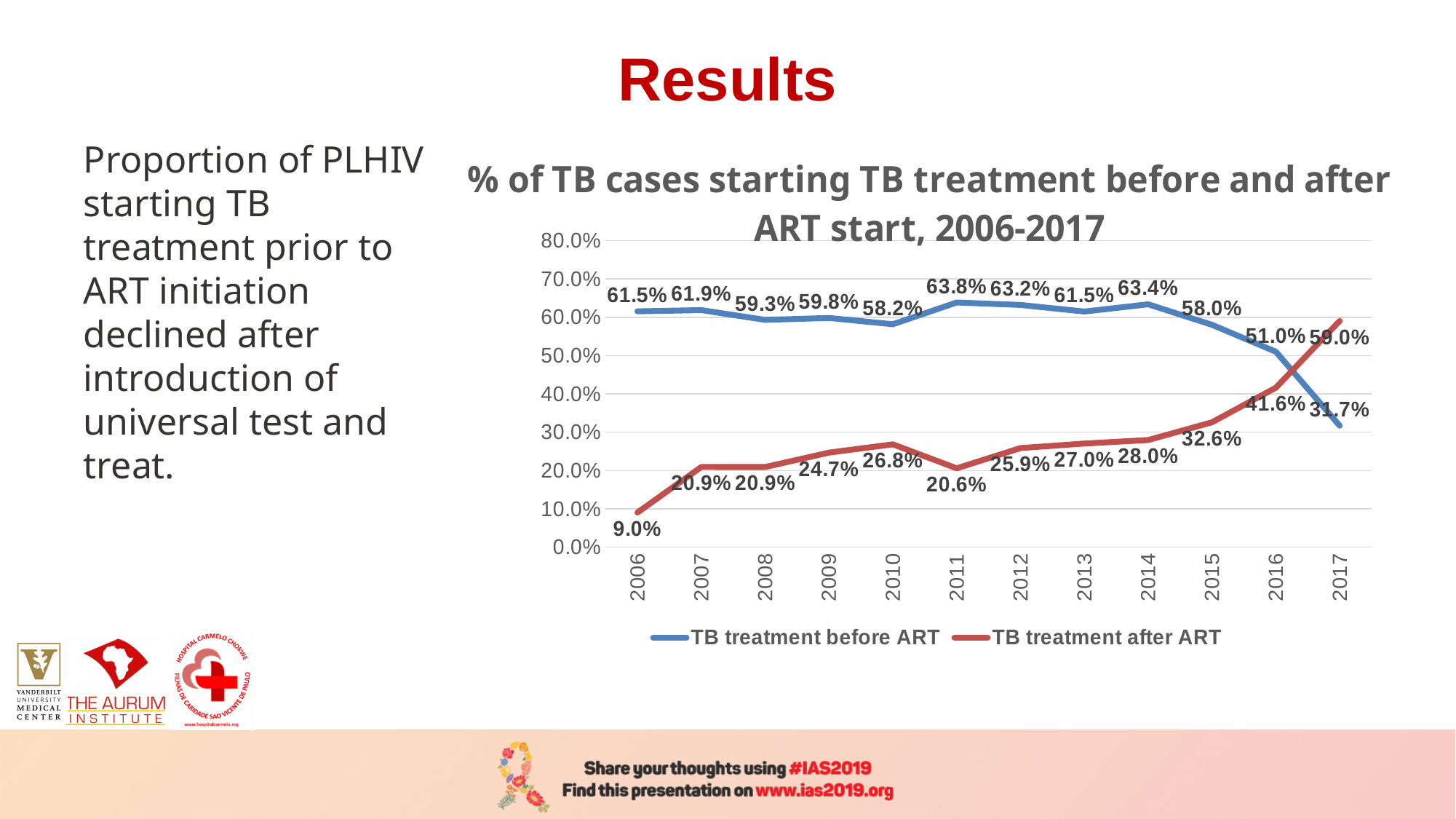
How many years are shown on the x axis? 12 In 2016, which is larger: TB treatment before ART or TB treatment after ART? TB treatment before ART What is the difference between TB treatment after ART and TB treatment before ART in 2017? 27.3 percentage points Does TB treatment after ART rise or fall from 2011 to 2017? Rise In which year is TB treatment after ART at its highest? 2017 What kind of chart is shown on the slide? Line chart How many series does the legend list? 2 What is the value for TB treatment after ART in 2015? 32.6% What is the value for TB treatment after ART in 2006? 9.0% In which year is TB treatment after ART at its lowest? 2006 What is the value for TB treatment before ART in 2011? 63.8% In which year is TB treatment before ART at its lowest? 2017